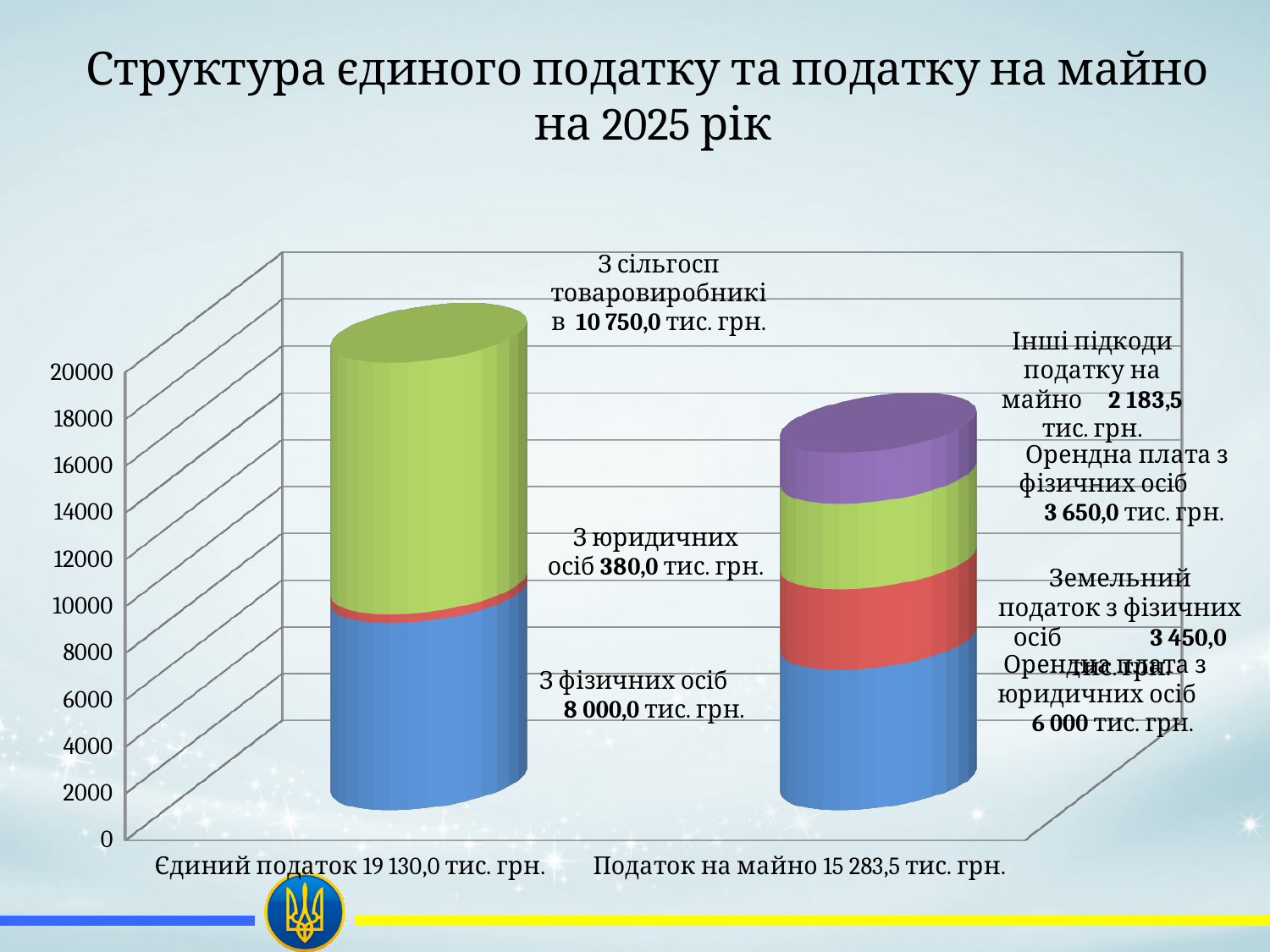
What is the value for 'Орендна плата з юридичних осіб' in the Податок на майно bar? 6 000 тис. грн. What is the difference between 'Орендна плата з фізичних осіб' and 'Земельний податок з фізичних осіб'? 200,0 тис. грн. Is the total of the Податок на майно bar greater or less than 16000? less What is the value for 'З сільгосп товаровиробників' in the Єдиний податок bar? 10 750,0 тис. грн. How many categories (bars) are shown on the chart? 2 What is the value for 'З юридичних осіб' in the Єдиний податок bar? 380,0 тис. грн. What is the total of the Єдиний податок stacked bar? 19 130,0 тис. грн. Which is larger: the Єдиний податок total or the Податок на майно total? Єдиний податок What is the total of the Податок на майно stacked bar? 15 283,5 тис. грн. What kind of chart is shown on the slide? Stacked bar chart What is the value for 'Інші підкоди податку на майно'? 2 183,5 тис. грн. What is the value for 'З фізичних осіб' in the Єдиний податок bar? 8 000,0 тис. грн.